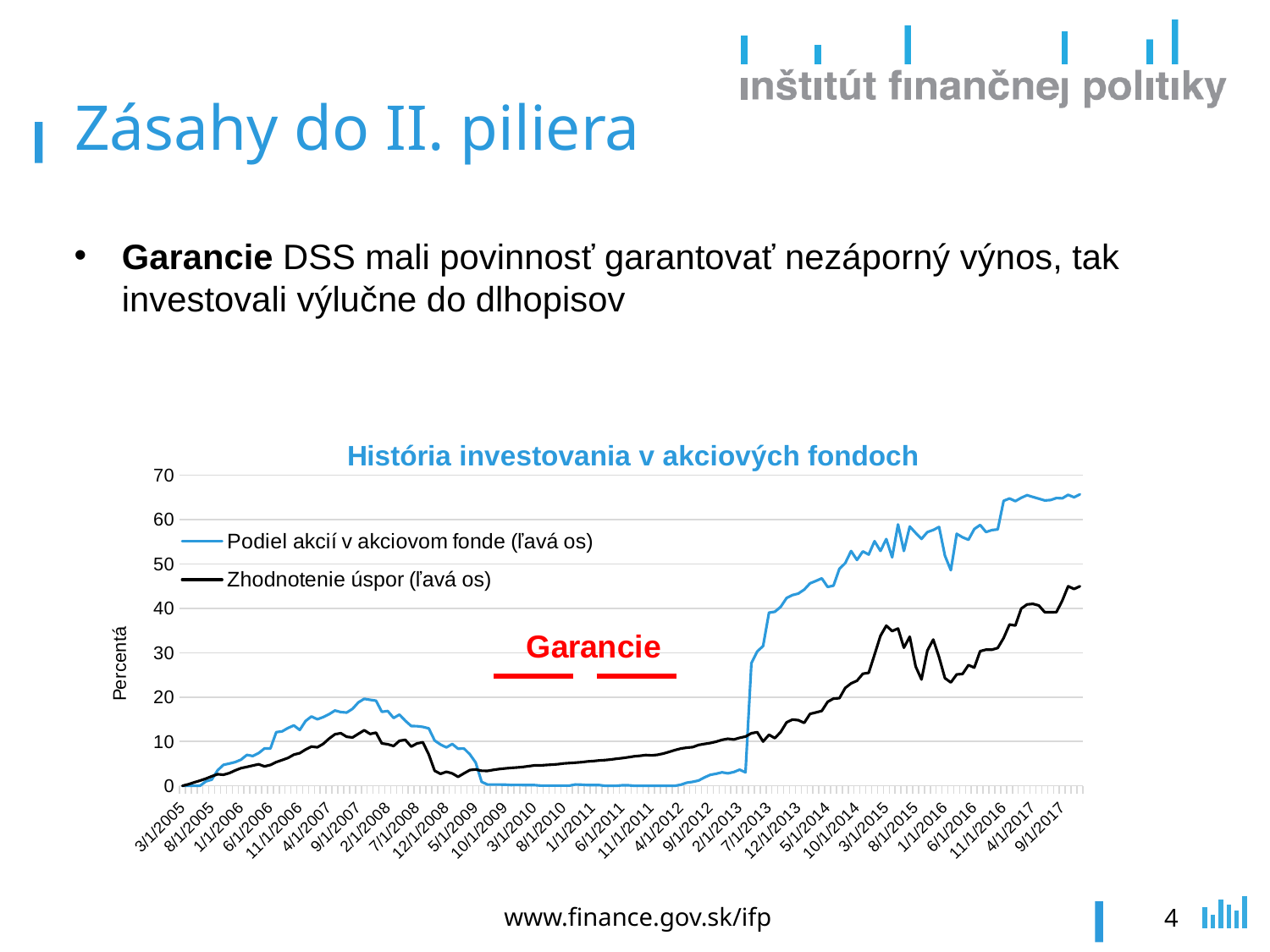
What is the title of the chart? História investovania v akciových fondoch At 9/1/2017, which series has the higher value: 'Podiel akcií v akciovom fonde (ľavá os)' or 'Zhodnotenie úspor (ľavá os)'? Podiel akcií v akciovom fonde (ľavá os) What kind of chart is shown on the slide? line chart Is the value of 'Podiel akcií v akciovom fonde (ľavá os)' at 3/1/2010 greater or less than 10? less Is the value of 'Podiel akcií v akciovom fonde (ľavá os)' at 9/1/2007 greater or less than 10? greater Does the 'Zhodnotenie úspor (ľavá os)' line rise or fall between 5/1/2009 and 2/1/2013? rise What is the label of the vertical axis of the chart? Percentá Is the value of 'Podiel akcií v akciovom fonde (ľavá os)' at 9/1/2017 greater or less than 60? greater How many series does the chart legend list? 2 Does the 'Podiel akcií v akciovom fonde (ľavá os)' line rise or fall between 2/1/2008 and 5/1/2009? fall